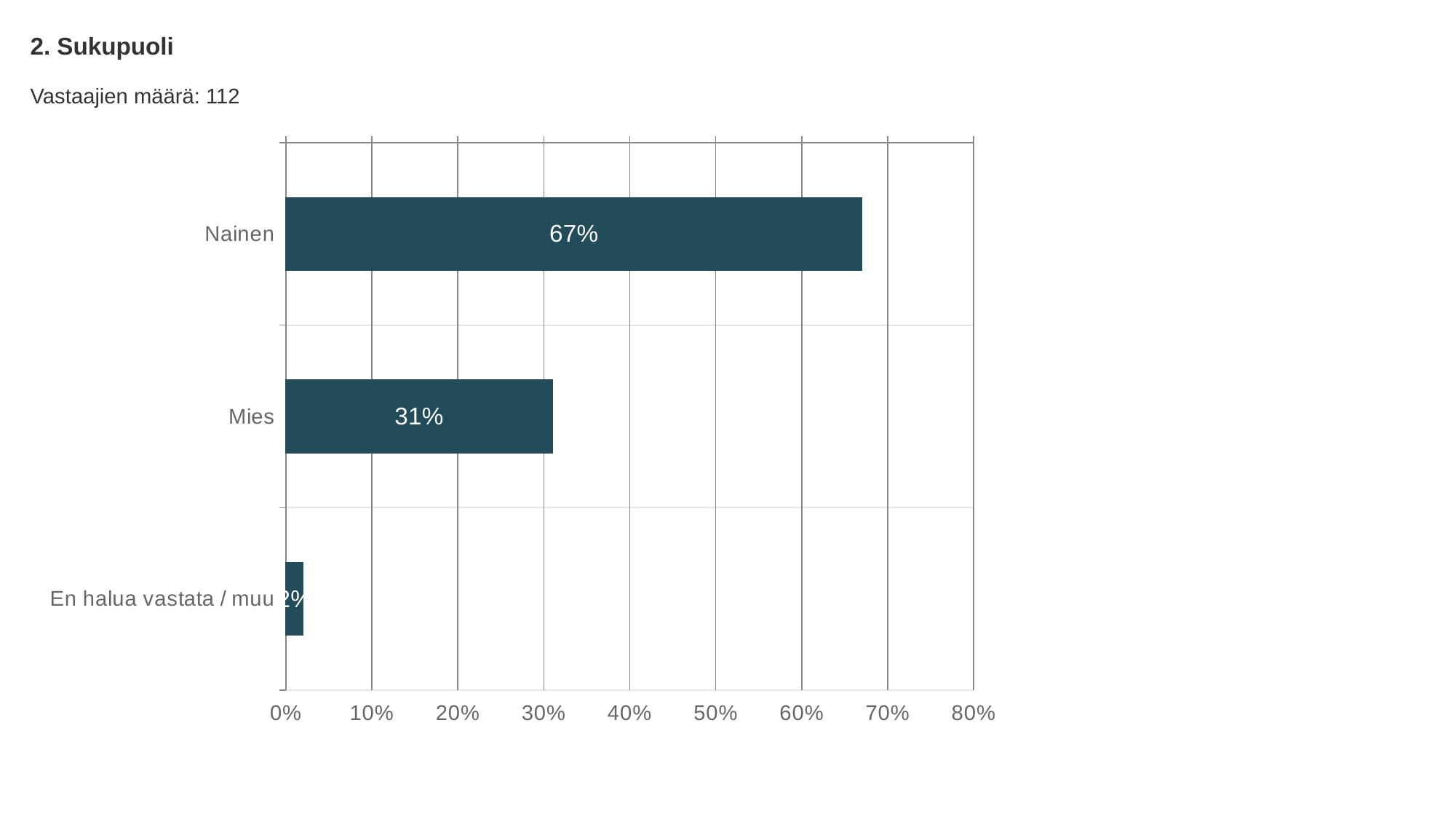
Is the value for Mies greater or less than 40%? less What is the difference between the values for Nainen and Mies? 36% What is the value for Mies? 31% How many categories are shown in the chart? 3 What is the value for Nainen? 67% Which category has the highest value? Nainen What kind of chart is shown on the slide? bar chart Which is larger, the value for Mies or the value for En halua vastata / muu? Mies What is the title of the chart? 2. Sukupuoli What is the value for En halua vastata / muu? 2% Is the value for Nainen greater or less than 60%? greater Which category has the lowest value? En halua vastata / muu